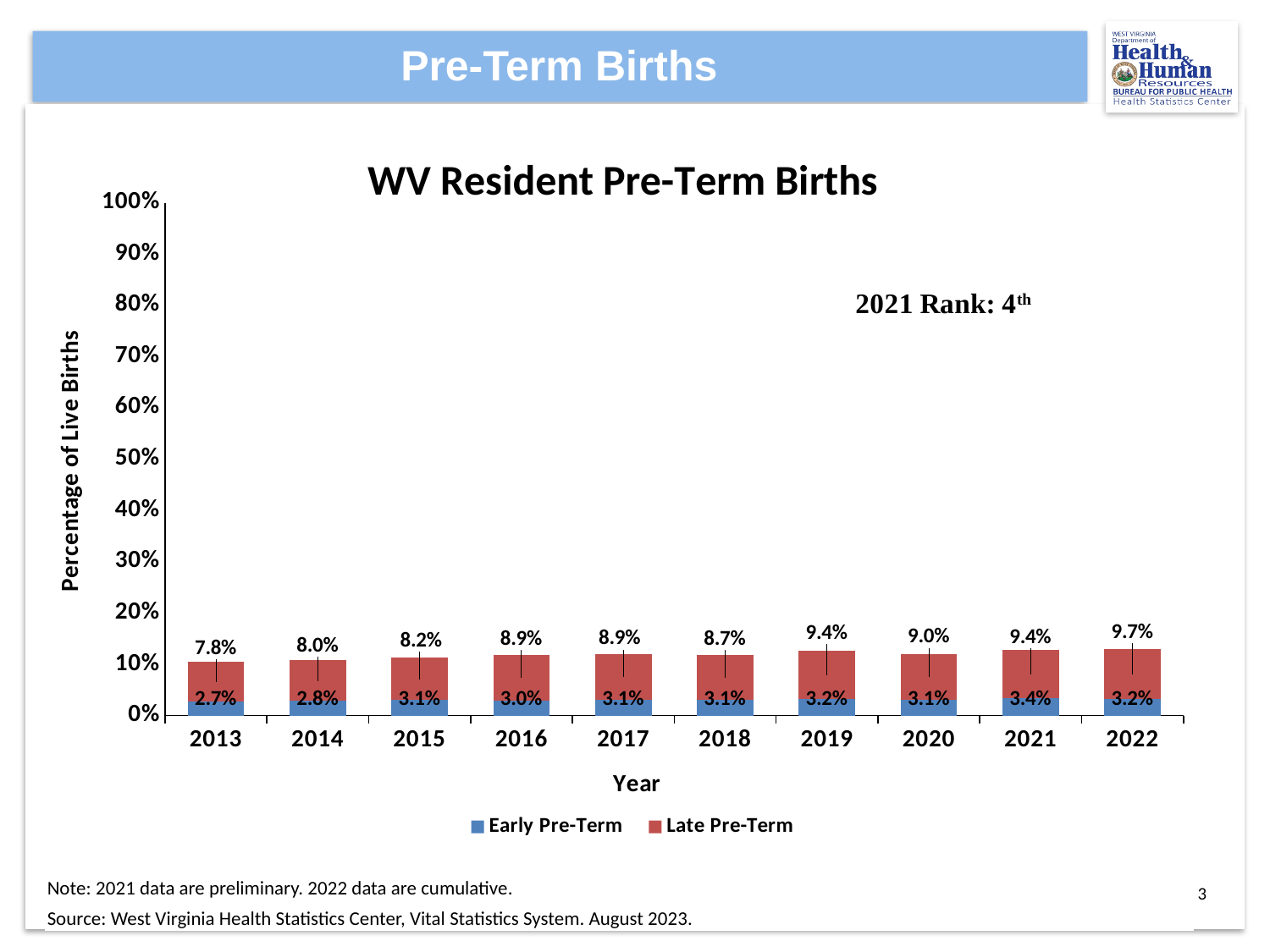
How many series does the legend list? 2 What is the difference between the Late Pre-Term values for 2022 and 2013? 1.9% Which year has the larger Late Pre-Term value, 2019 or 2020? 2019 What is the Late Pre-Term value for 2022? 9.7% What is the Early Pre-Term value for 2021? 3.4% Is the total height of the 2022 bar greater or less than 20%? less Which year has the highest Late Pre-Term value? 2022 What kind of chart is shown on the slide? Stacked bar chart How many years are shown on the x axis? 10 Which year has the lowest Early Pre-Term value? 2013 What is the title of the chart? WV Resident Pre-Term Births What is the Early Pre-Term value for 2016? 3.0%